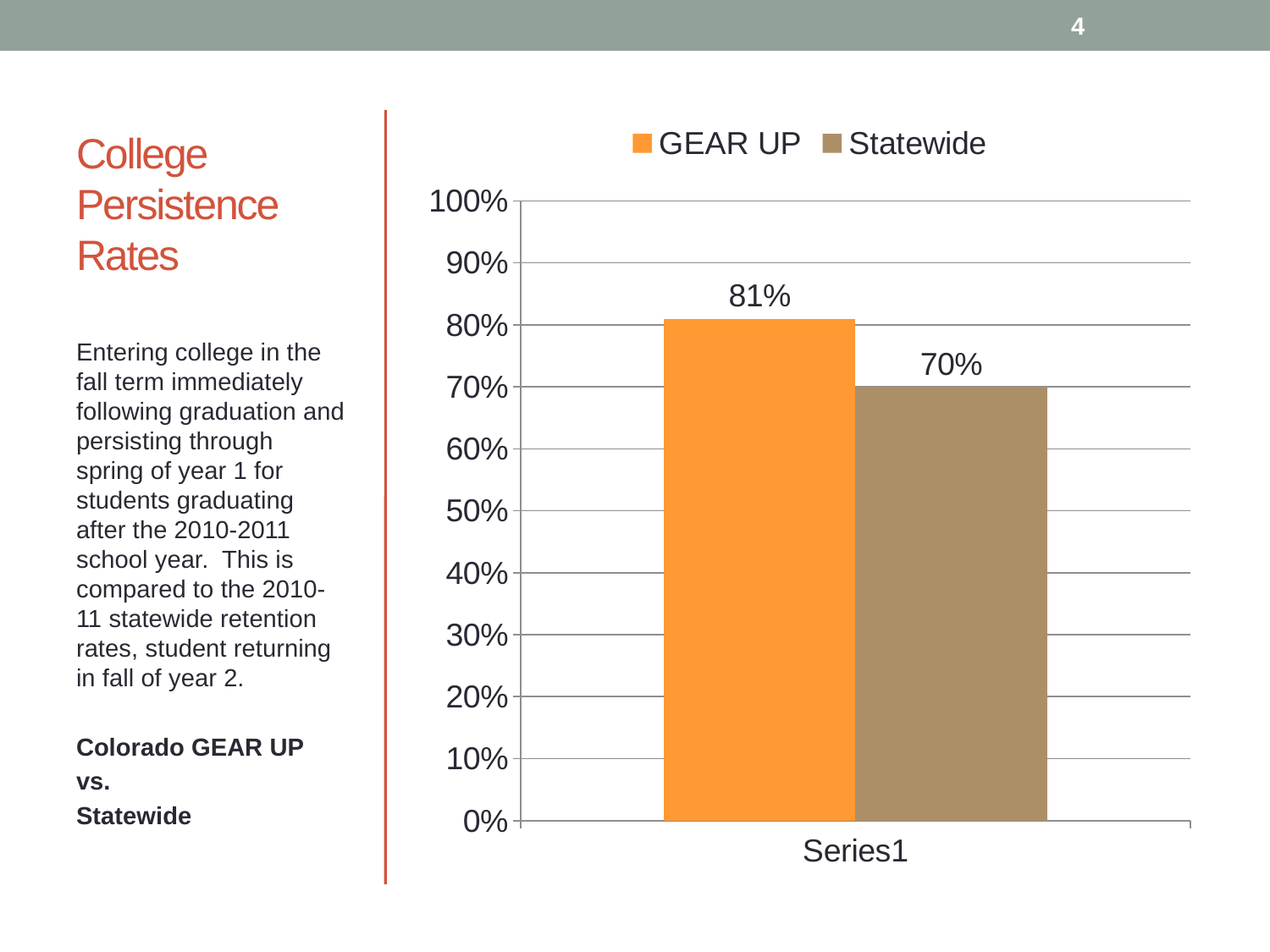
What is the college persistence rate for Statewide? 70% What kind of chart is shown on the slide? bar chart What colour is the GEAR UP bar? orange How many series does the legend list? 2 Is the GEAR UP value larger or smaller than the Statewide value? larger Which series has the higher value, GEAR UP or Statewide? GEAR UP What is the difference between the GEAR UP and Statewide values? 11% What is the college persistence rate for GEAR UP? 81% Is the value for Statewide greater or less than 80%? less What is the label on the x axis under the bars? Series1 Which series has the lower value, GEAR UP or Statewide? Statewide Is the value for GEAR UP greater or less than 80%? greater